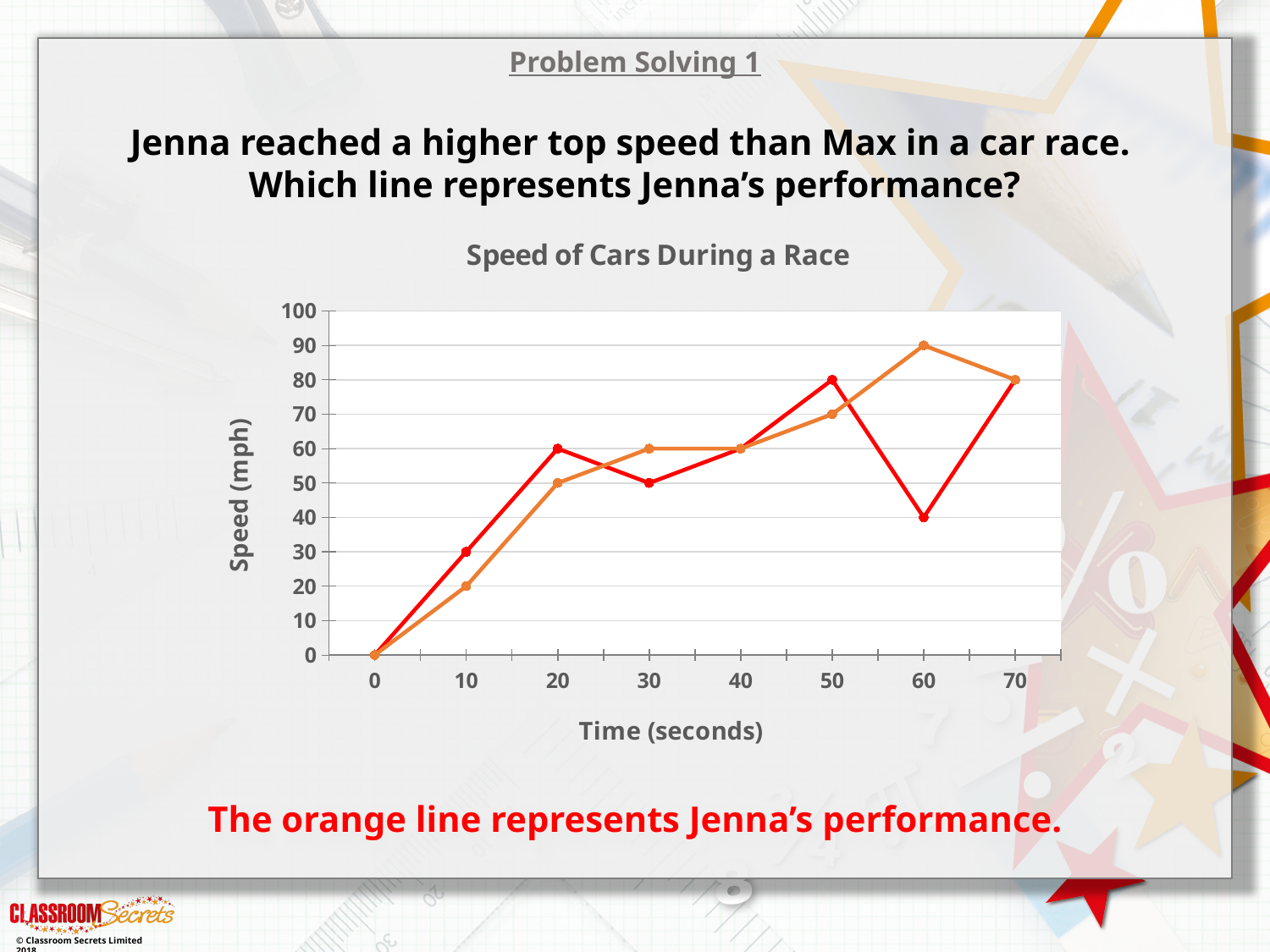
What is the speed of the orange line at 60 seconds? 90 What type of chart is shown on the slide? line chart How many time points are plotted on the x axis for each line? 8 What is the speed of the red line at 60 seconds? 40 What is the speed of the orange line at 20 seconds? 50 At 50 seconds, which line shows the higher speed, red or orange? red What is the title of the chart? Speed of Cars During a Race What is the difference in speed between the orange line and the red line at 60 seconds? 50 Does the red line rise or fall between 50 and 60 seconds? fall What is the speed of the red line at 10 seconds? 30 At what time does the orange line reach its highest speed? 60 How many lines are plotted on the chart? 2